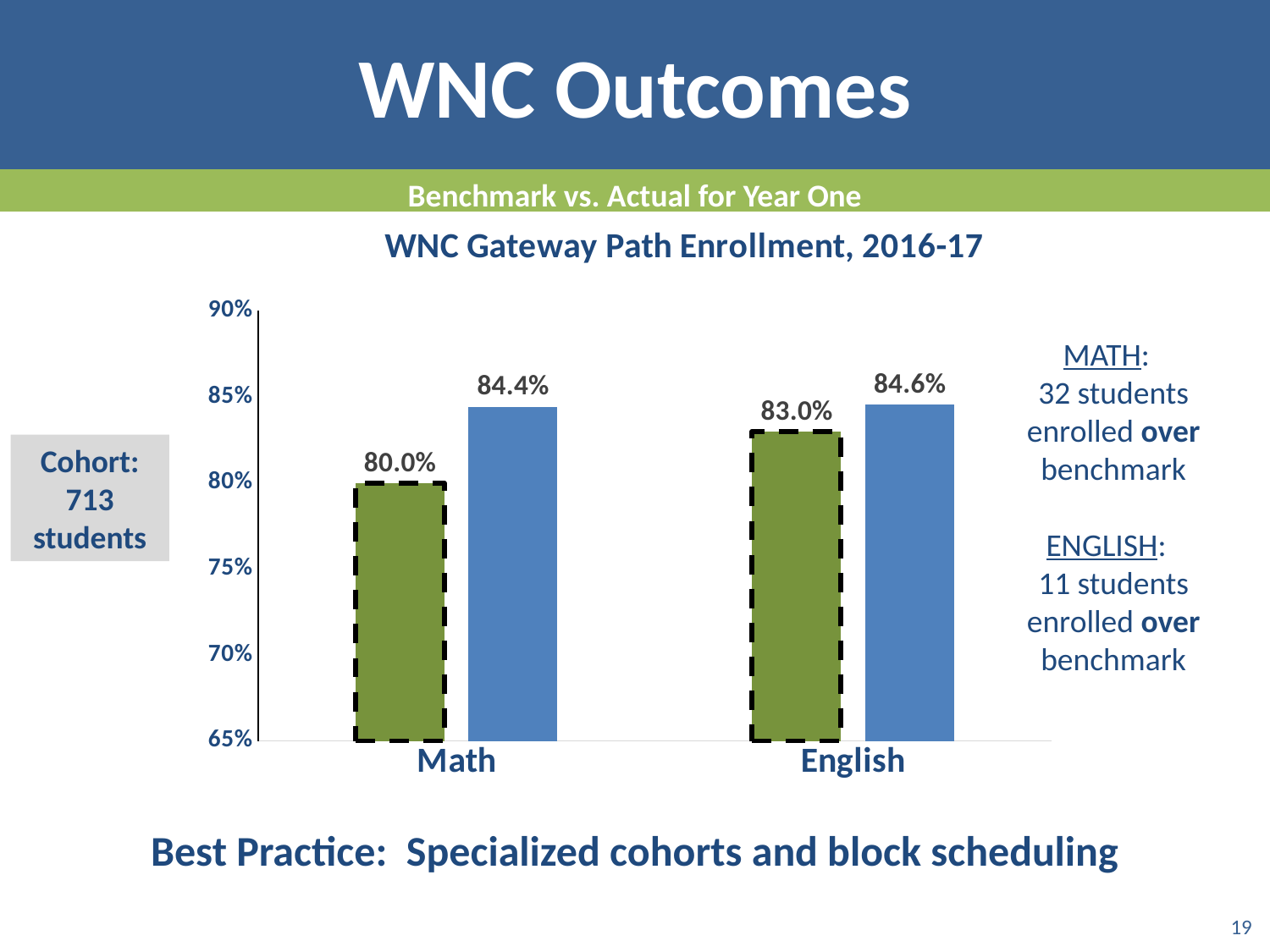
How many categories are shown on the x axis? 2 What is the difference between the blue bar and the green bar for Math? 4.4% Which is larger, the green bar for Math or the green bar for English? the green bar for English Is the value of the green bar for English greater or less than 80%? greater What is the value of the green bar for Math? 80.0% What is the value of the green bar for English? 83.0% What is the value of the blue bar for English? 84.6% What kind of chart is shown on the slide? bar chart What is the difference between the blue bar and the green bar for English? 1.6% What is the value of the blue bar for Math? 84.4% What is the title of the chart? WNC Gateway Path Enrollment, 2016-17 Which bar has the lowest value in the chart? the green bar for Math (80.0%)